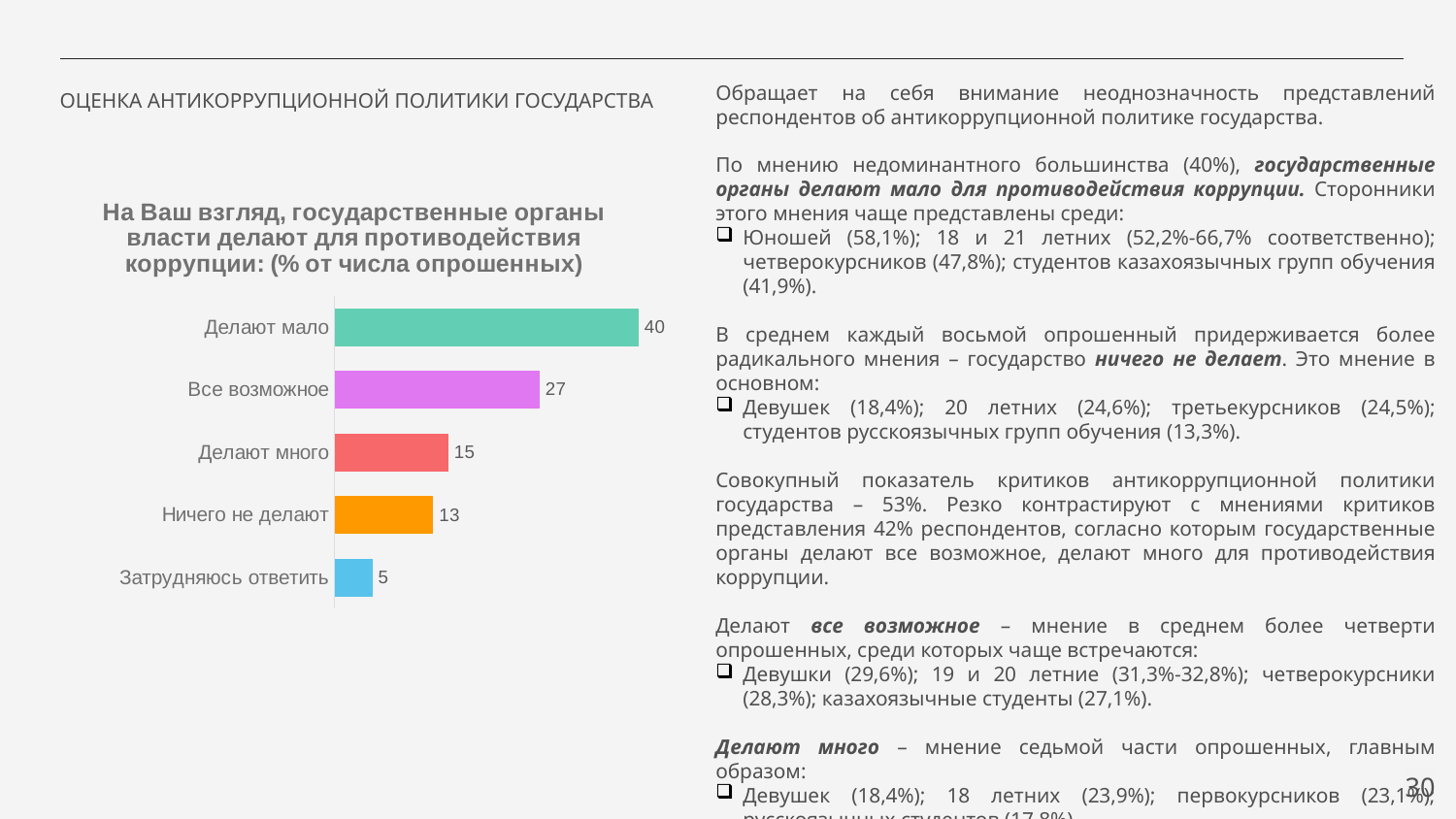
How many categories are shown in the chart? 5 What is the difference between the values for 'Делают много' and 'Ничего не делают'? 2 What is the title of the chart? На Ваш взгляд, государственные органы власти делают для противодействия коррупции: (% от числа опрошенных) What is the value for 'Делают мало'? 40 Which category has the highest value? Делают мало What is the difference between the values for 'Делают мало' and 'Все возможное'? 13 What is the value for 'Все возможное'? 27 What kind of chart is shown on the slide? Bar chart Which category has the lowest value? Затрудняюсь ответить What is the value for 'Затрудняюсь ответить'? 5 What is the value for 'Ничего не делают'? 13 Which is larger, the value for 'Все возможное' or the value for 'Делают много'? Все возможное